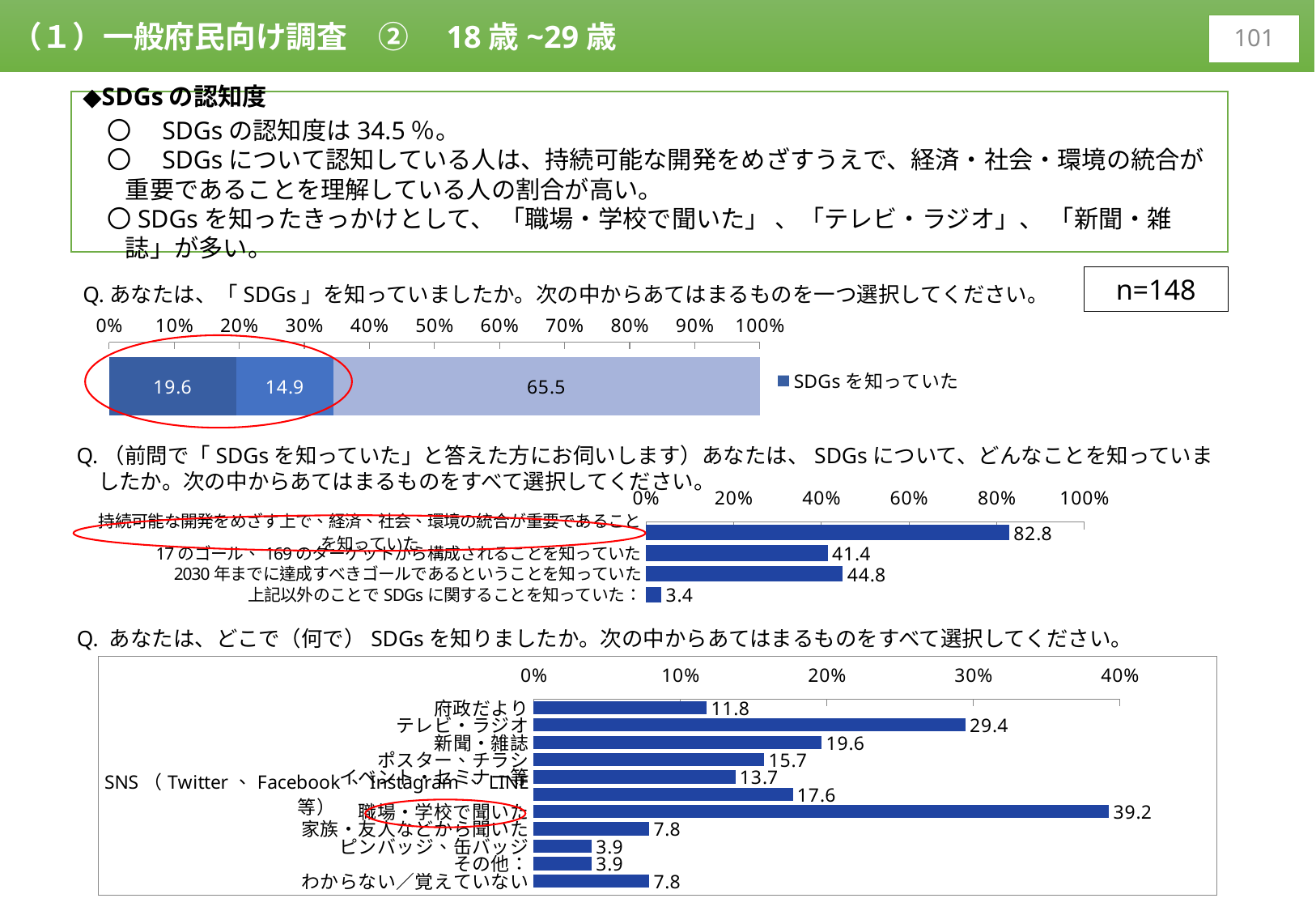
In the middle chart (what people knew about SDGs), which category has the lowest value? 上記以外のことでSDGsに関することを知っていた In the bottom chart (where people learned about SDGs), what is the difference between 職場・学校で聞いた and テレビ・ラジオ? 9.8 What type of chart is the middle chart (what people knew about SDGs)? bar chart How many categories are shown in the bottom chart (where people learned about SDGs)? 11 In the middle chart (what people knew about SDGs), what is the value for 2030年までに達成すべきゴールであるということを知っていた? 44.8 In the bottom chart (where people learned about SDGs), which is larger: 新聞・雑誌 or ポスター、チラシ? 新聞・雑誌 In the bottom chart (where people learned about SDGs), which category has the highest value? 職場・学校で聞いた In the bottom chart (where people learned about SDGs), what is the value for テレビ・ラジオ? 29.4 In the bottom chart (where people learned about SDGs), what is the value for 職場・学校で聞いた? 39.2 In the top stacked bar chart (whether respondents knew SDGs), what is the total of the two segments circled in red (19.6 and 14.9)? 34.5 In the top stacked bar chart (whether respondents knew SDGs), what is the value of the largest segment? 65.5 In the middle chart (what people knew about SDGs), what is the difference between the highest value and 17のゴール、169のターゲットから構成されることを知っていた? 41.4